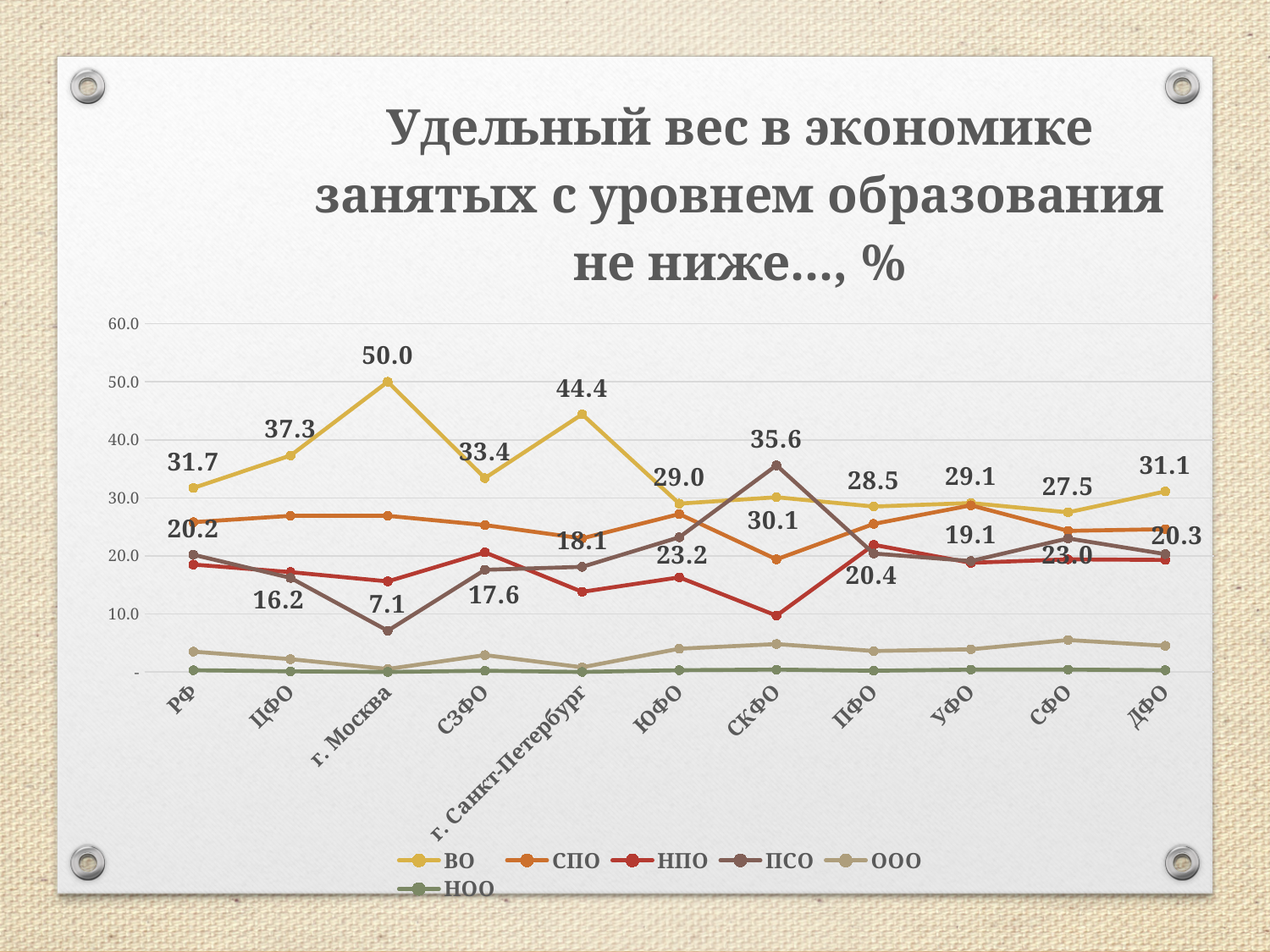
What is the difference between the ВО values for г. Москва and г. Санкт-Петербург? 5.6 For which category is the ВО series highest? г. Москва For which category is the ПСО series lowest? г. Москва Which series is drawn in yellow? ВО What is the value of the ПСО series for г. Москва? 7.1 What is the value of the ВО series for г. Москва? 50.0 Which has the larger ВО value, ЦФО or СЗФО? ЦФО What kind of chart is shown on the slide? line chart How many categories are shown along the x axis? 11 Is the value of the СПО series for РФ greater or less than 20.0? greater How many series does the legend list? 6 What is the value of the ПСО series for СКФО? 35.6